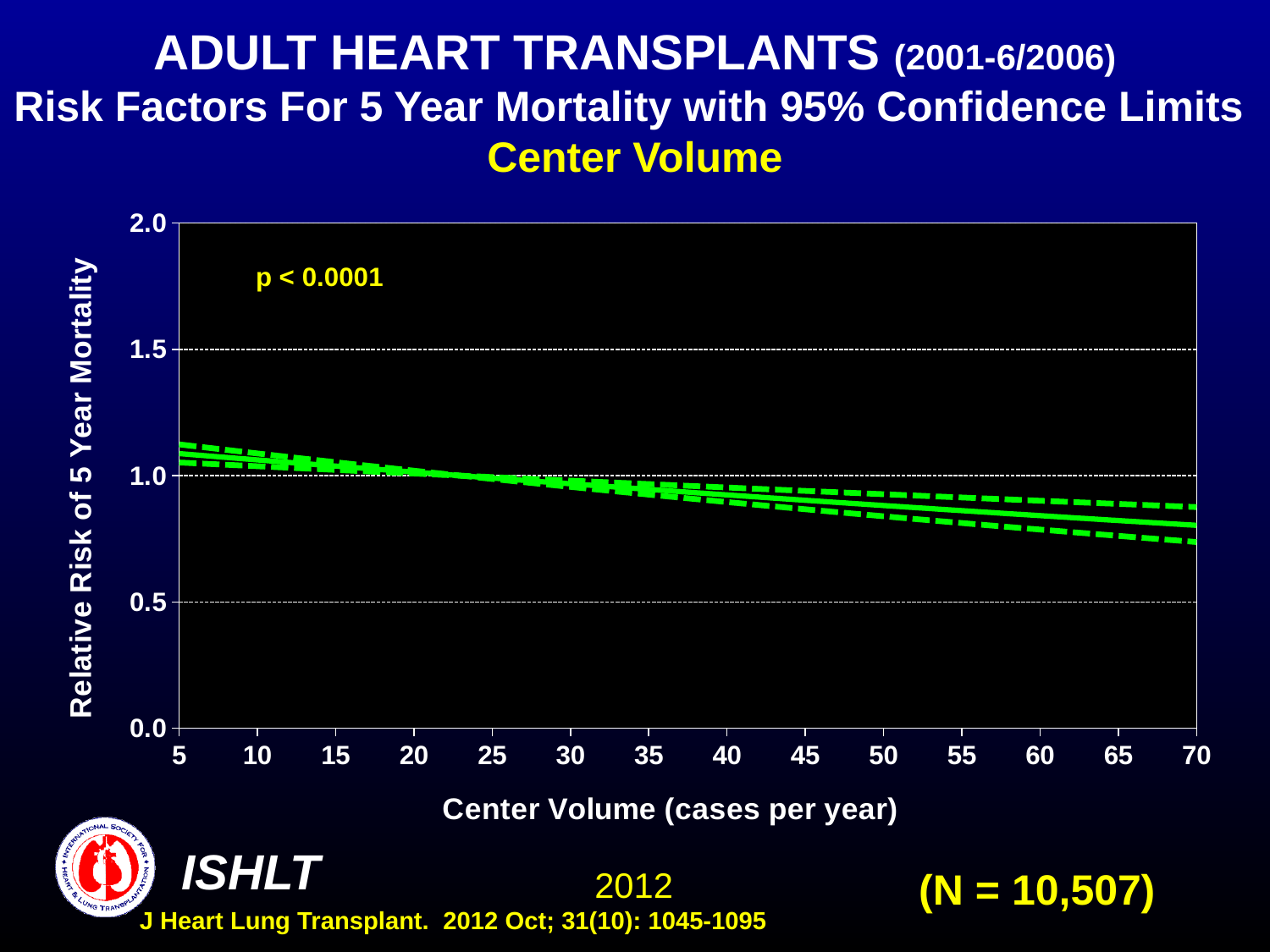
What kind of chart is shown on the slide? line chart Is the relative risk of 5 year mortality at a center volume of 5 cases per year greater or less than 1.5? less Does the relative risk of 5 year mortality rise or fall as center volume increases along the x axis? fall What is the highest center volume value labelled on the x axis? 70 Is the relative risk of 5 year mortality at a center volume of 70 cases per year greater or less than 1.0? less What p-value is printed on the chart? p < 0.0001 What is the label of the x axis of the chart? Center Volume (cases per year) Is the relative risk of 5 year mortality at a center volume of 5 cases per year greater or less than 1.0? greater How many tick labels are shown on the x axis of the chart? 14 What is the lowest center volume value labelled on the x axis? 5